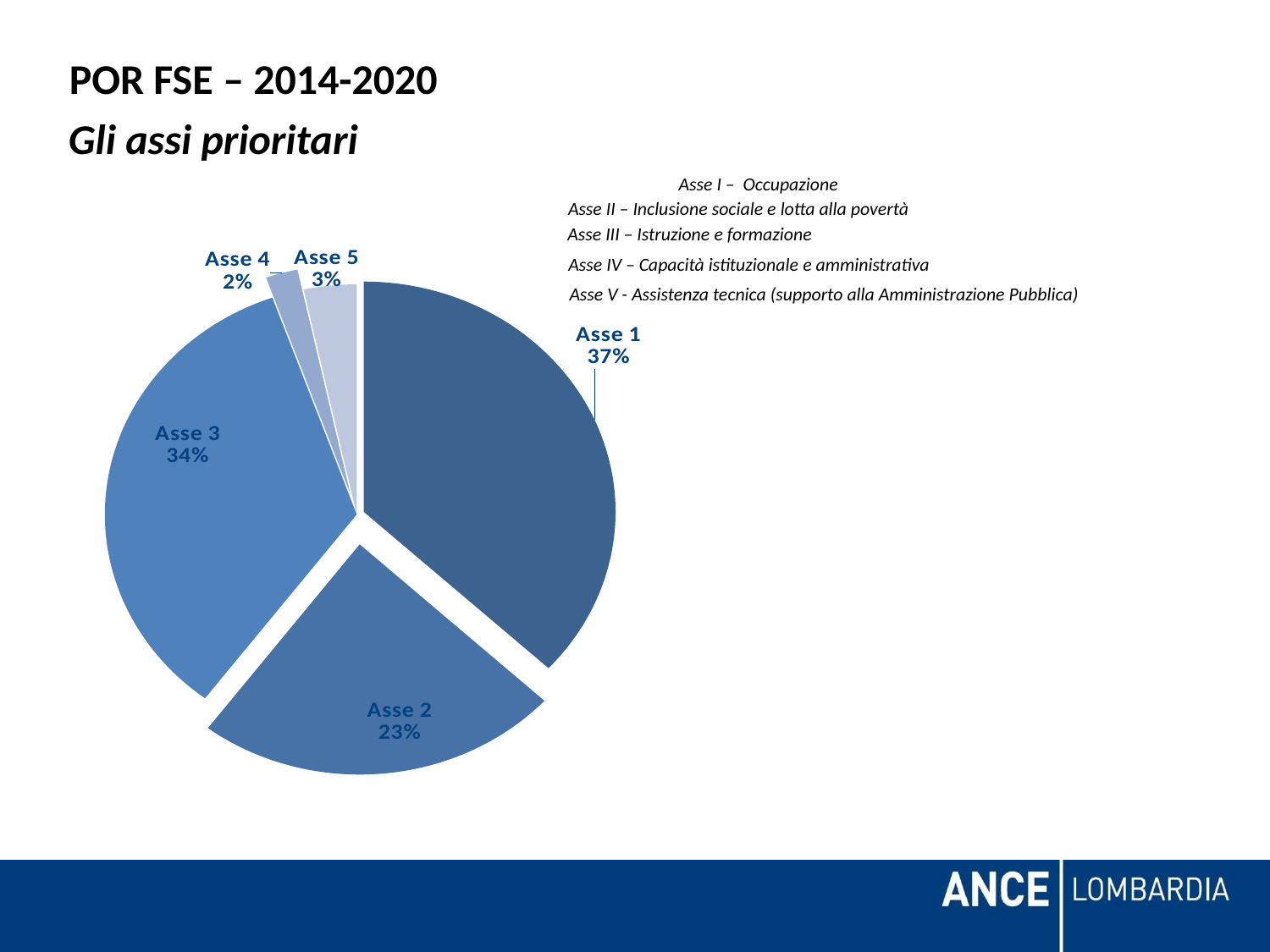
Which is larger, Asse 2 or Asse 3? Asse 3 What is the value shown for Asse 5? 3% Which slice of the pie is the smallest? Asse 4 According to the text on the slide, what does Asse I refer to? Occupazione What is the value shown for Asse 4? 2% How many slices does the pie chart have? 5 What is the value shown for Asse 3? 34% What is the difference in percentage points between Asse 1 and Asse 3? 3 What share of the pie does Asse 1 represent? 37% What is the value shown for Asse 2? 23% What type of chart is shown on the slide? pie chart Which slice of the pie is the largest? Asse 1